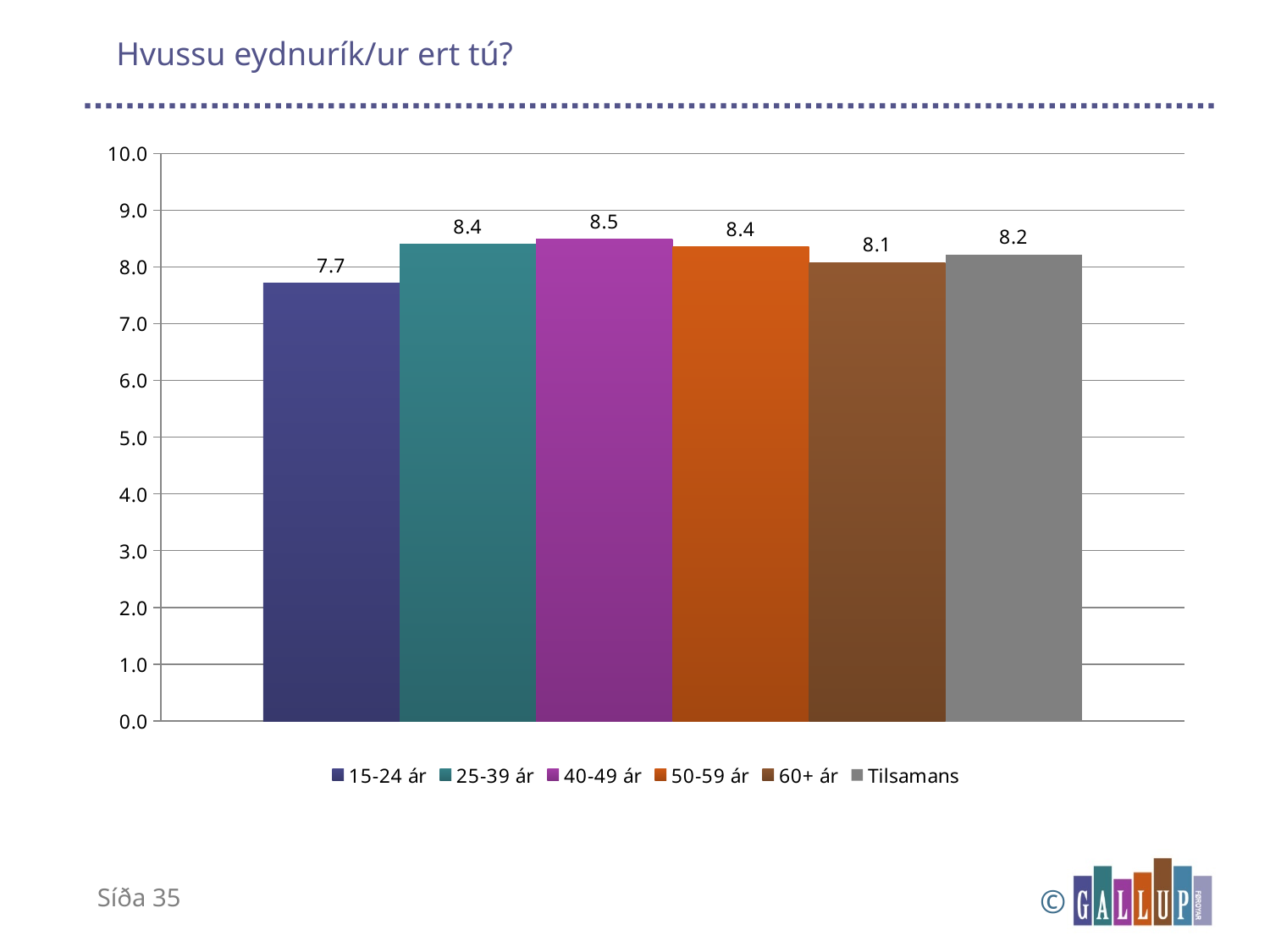
What kind of chart is shown on the slide? bar chart Is the value for 15-24 ár greater or less than 8.0? less What is the value for 60+ ár? 8.1 What is the value for Tilsamans? 8.2 How many bars are shown in the chart? 6 Which group has the highest value? 40-49 ár What is the value for 40-49 ár? 8.5 What is the value for 15-24 ár? 7.7 Which group has the lowest value? 15-24 ár What is the difference between the values for 40-49 ár and 15-24 ár? 0.8 How many entries does the legend list? 6 Which is larger, the value for 25-39 ár or the value for 60+ ár? 25-39 ár